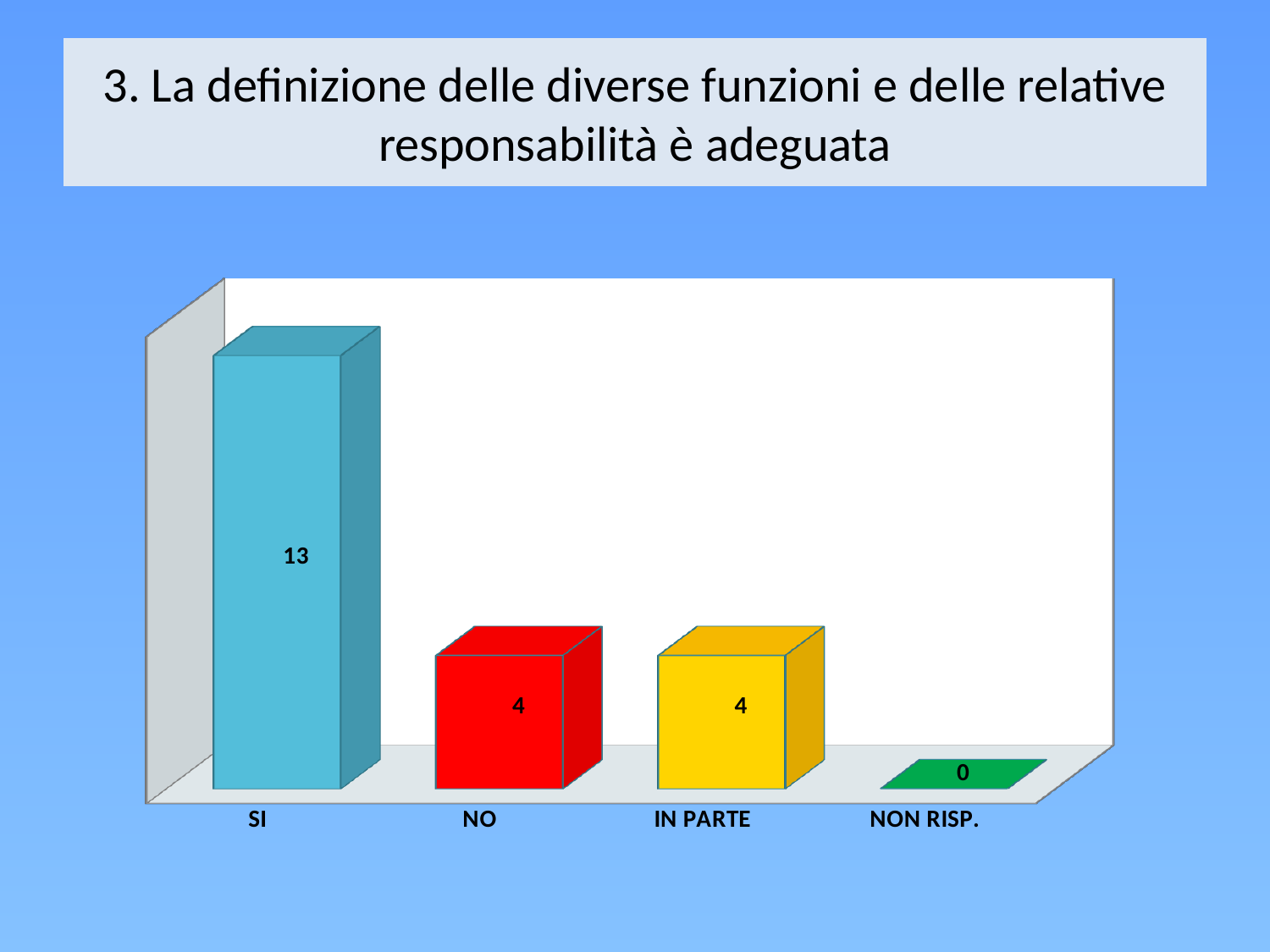
What is the difference between the values for SI and NO? 9 How many categories are shown on the x axis? 4 Which category has the highest value? SI Which is larger, the value for SI or the value for IN PARTE? SI What kind of chart is shown on the slide? bar chart What is the value for IN PARTE? 4 What is the value for SI? 13 What is the value for NON RISP.? 0 What is the value for NO? 4 What is the difference between the values for IN PARTE and NON RISP.? 4 Which category has the lowest value? NON RISP. What colour is the bar for NO? red